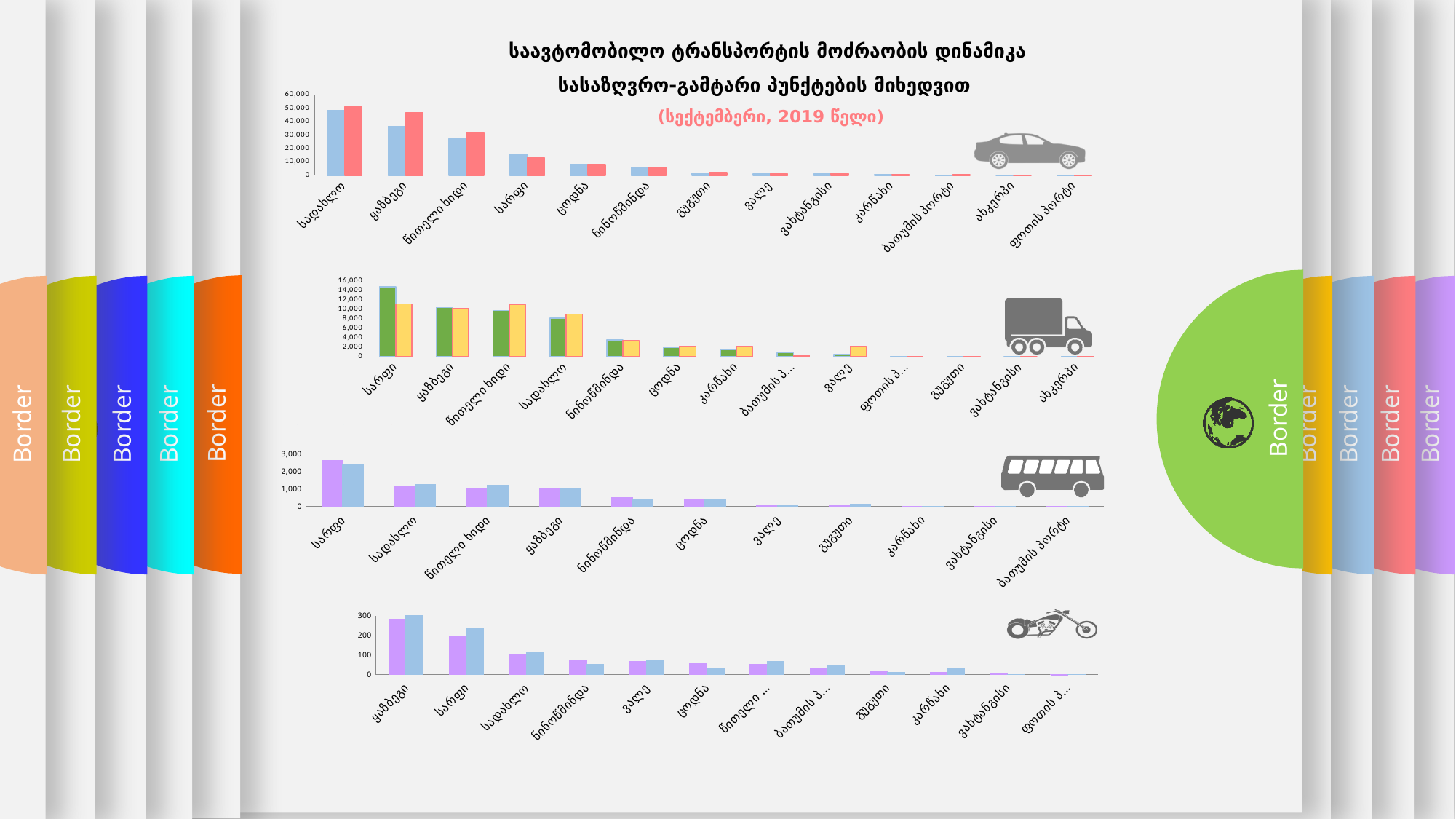
How many categories are shown on the x axis of the top chart (car icon)? 13 In the bottom chart (motorcycle icon), which category has the highest values? ყაზბეგი In the bottom chart (motorcycle icon), do the values generally rise or fall from left to right along the x axis? fall In the third chart (bus icon), is the purple bar for სარფი greater or less than 2,000? greater In the second chart (truck icon), is the green bar for სარფი greater or less than 12,000? greater In the top chart (car icon), for ყაზბეგი, which bar is larger, the blue one or the red one? the red one In the top chart (car icon), is the blue bar for ყაზბეგი greater or less than 40,000? less In the top chart (car icon), which category has the highest values? სადახლო How many categories are shown on the x axis of the bottom chart (motorcycle icon)? 12 How many categories are shown on the x axis of the third chart (bus icon)? 11 In the second chart (truck icon), which category has the tallest bar? სარფი What kind of chart is the top chart with the car icon? bar chart